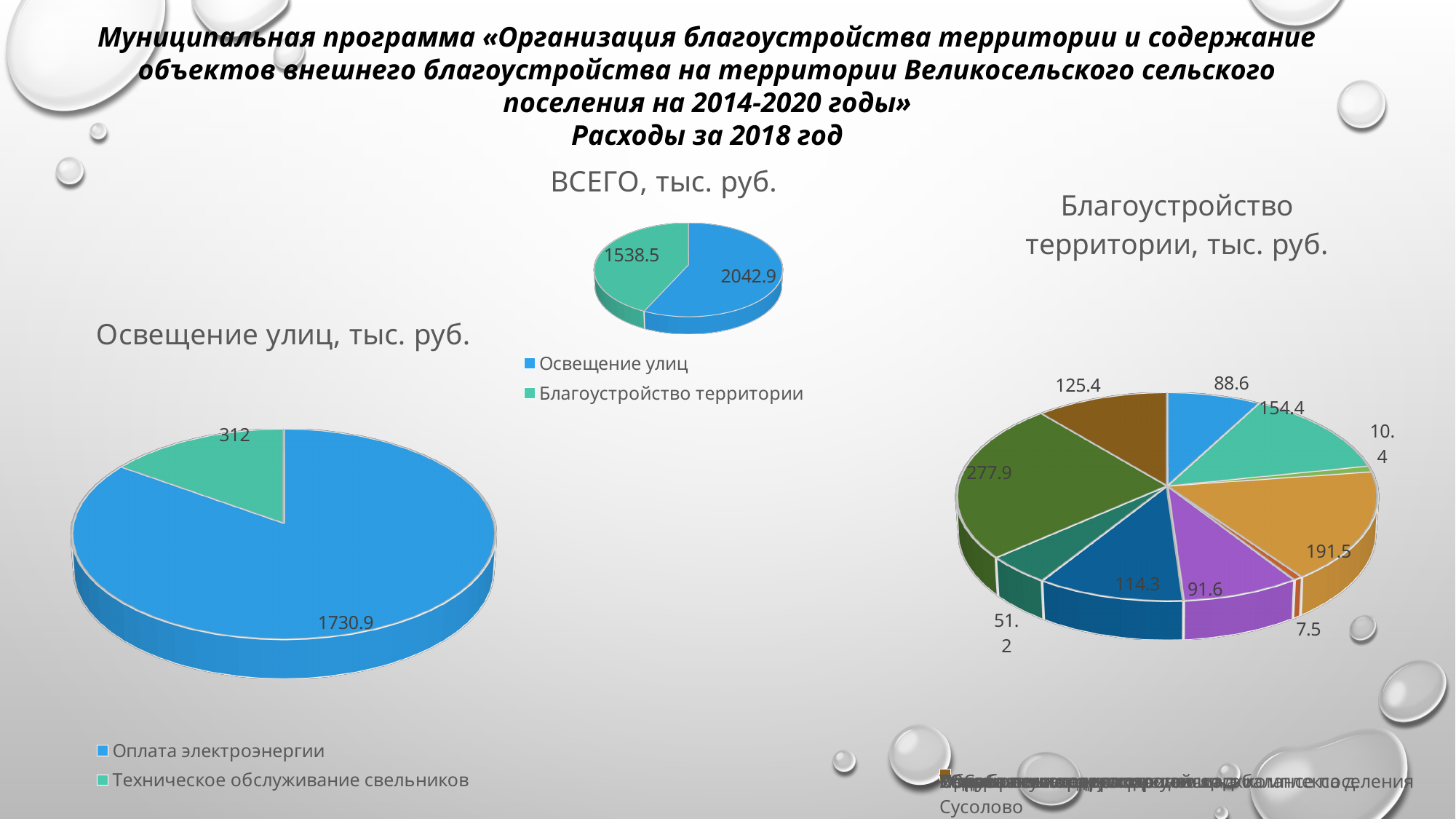
In the chart titled "Освещение улиц, тыс. руб.", which slice is the largest? Оплата электроэнергии In the chart titled "ВСЕГО, тыс. руб.", which is larger: Освещение улиц or Благоустройство территории? Освещение улиц In the chart titled "Благоустройство территории, тыс. руб.", what is the value of the smallest slice? 7.5 What kind of chart is the chart titled "ВСЕГО, тыс. руб."? Pie chart In the chart titled "Благоустройство территории, тыс. руб.", what is the value of the largest slice? 277.9 In the chart titled "Освещение улиц, тыс. руб.", what is the value for Техническое обслуживание свельников? 312 In the chart titled "ВСЕГО, тыс. руб.", what is the value for Благоустройство территории? 1538.5 In the chart titled "ВСЕГО, тыс. руб.", what is the difference between Освещение улиц and Благоустройство территории? 504.4 In the chart titled "ВСЕГО, тыс. руб.", what is the value for Освещение улиц? 2042.9 How many entries does the legend of the chart titled "ВСЕГО, тыс. руб." list? 2 How many slices does the chart titled "Благоустройство территории, тыс. руб." have? 10 In the chart titled "Освещение улиц, тыс. руб.", what is the value for Оплата электроэнергии? 1730.9